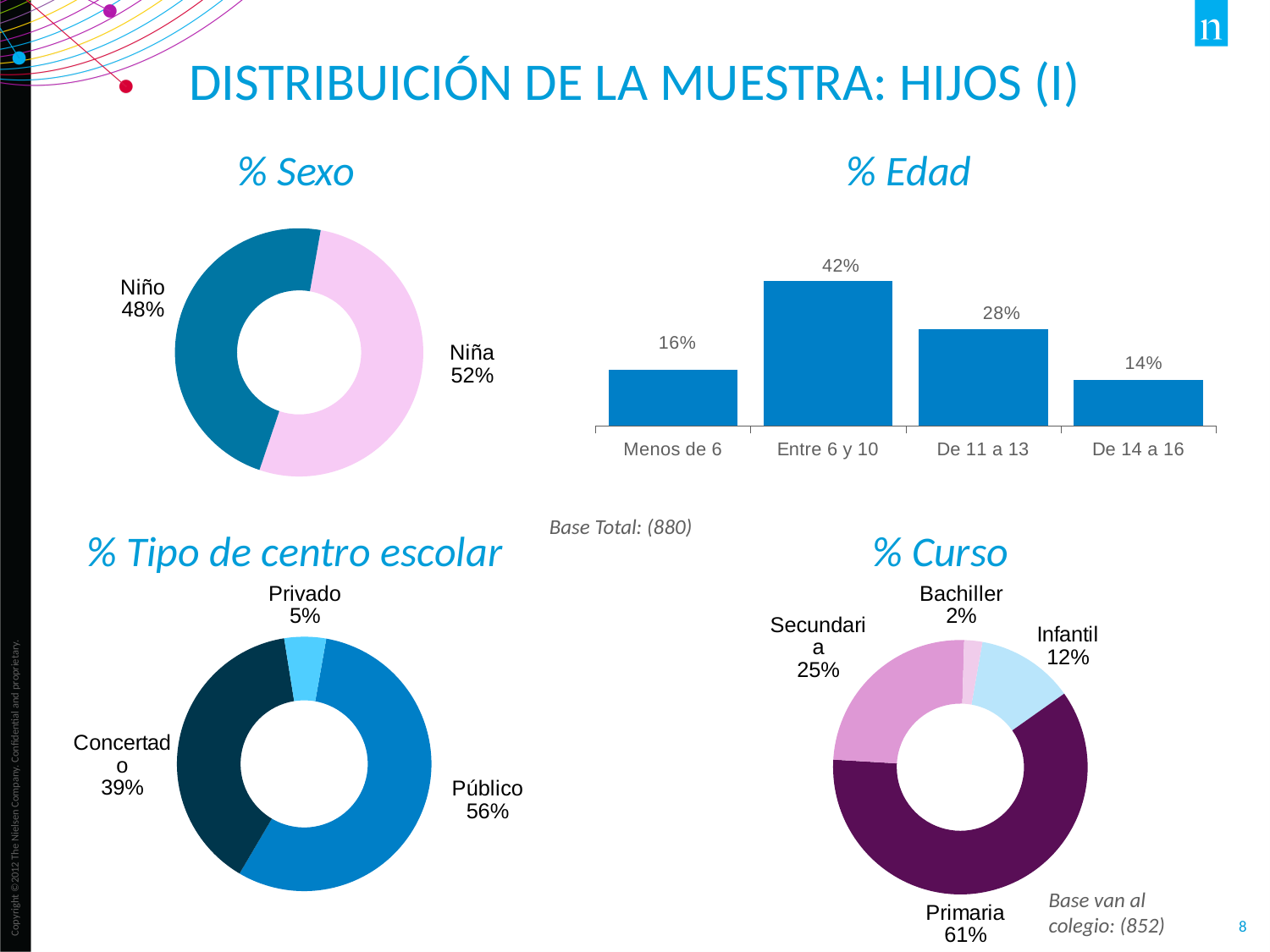
In the '% Edad' chart, what is the difference between 'Entre 6 y 10' and 'De 11 a 13'? 14% In the '% Tipo de centro escolar' chart, which category has the largest share? Público In the '% Sexo' chart, what percentage is Niña? 52% In the '% Tipo de centro escolar' chart, what percentage is Concertado? 39% In the '% Edad' chart, which age group has the lowest value? De 14 a 16 In the '% Curso' chart, which is larger, Infantil or Secundaria? Secundaria In the '% Sexo' chart, what is the difference between Niña and Niño? 4% In the '% Curso' chart, which category has the smallest share? Bachiller In the '% Edad' chart, how many age categories are shown? 4 In the '% Edad' chart, what is the value for 'Entre 6 y 10'? 42% In the '% Curso' chart, what percentage is Secundaria? 25% What kind of chart is the '% Edad' chart? Bar chart